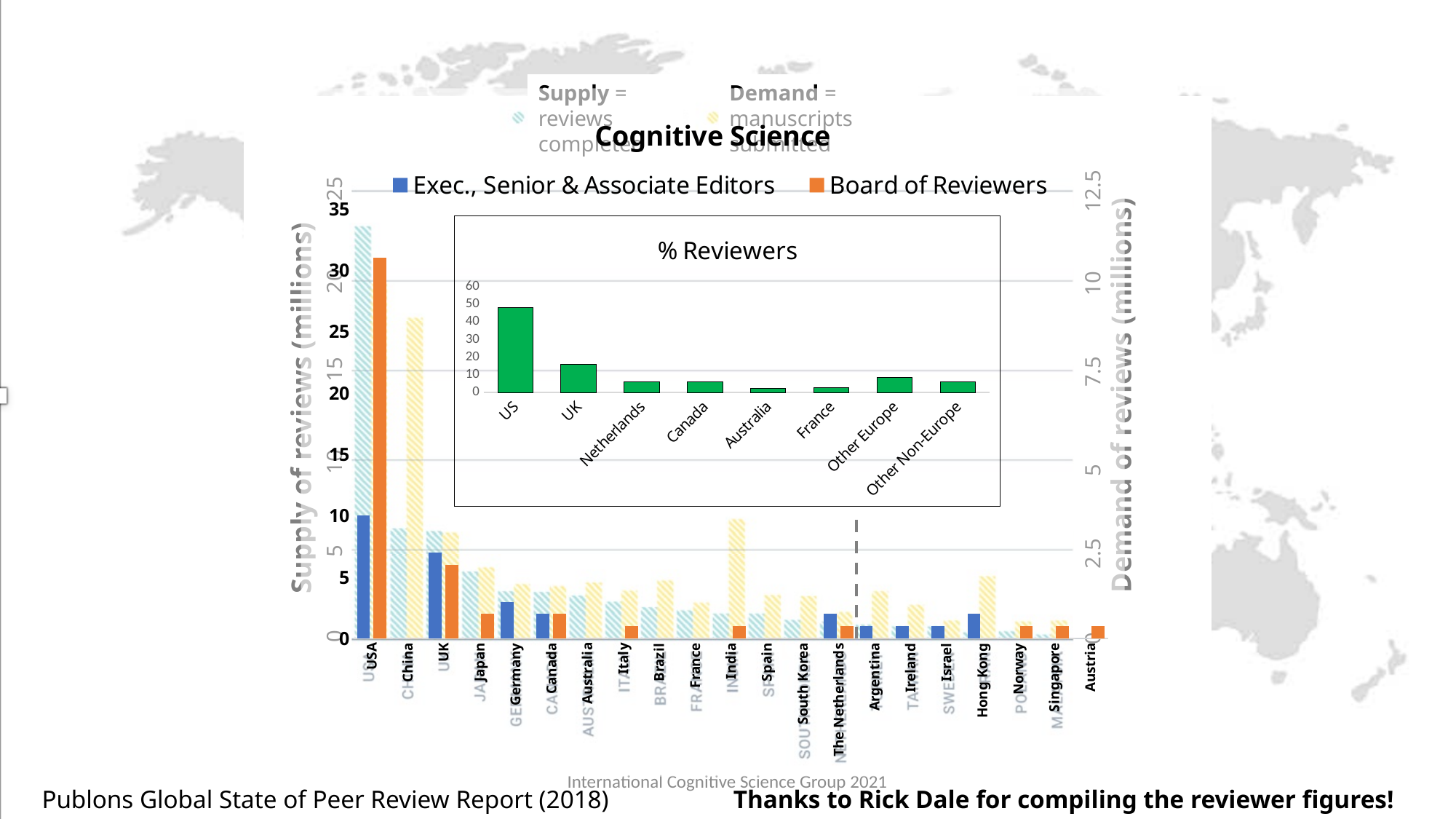
In the Cognitive Science chart, is the Exec., Senior & Associate Editors value for UK greater or less than 5? greater In the Cognitive Science chart, for USA, which is larger: Exec., Senior & Associate Editors or Board of Reviewers? Board of Reviewers In the inset % Reviewers chart, how many categories are shown on the x axis? 8 In the Cognitive Science chart, which country has the highest Board of Reviewers value? USA In the Cognitive Science chart, how many series does the legend list? 2 In the Cognitive Science chart, what are the two series named in the legend? Exec., Senior & Associate Editors; Board of Reviewers In the Cognitive Science chart, how many countries are shown on the x axis? 21 In the Cognitive Science chart, which country has the highest Exec., Senior & Associate Editors value? USA In the Cognitive Science chart, what kind of chart is used to show the editor and reviewer counts? bar chart In the inset % Reviewers chart, is the value for UK greater or less than 20? less In the inset % Reviewers chart, which category has the highest value? US In the Cognitive Science chart, is the Board of Reviewers value for USA greater or less than 25? greater